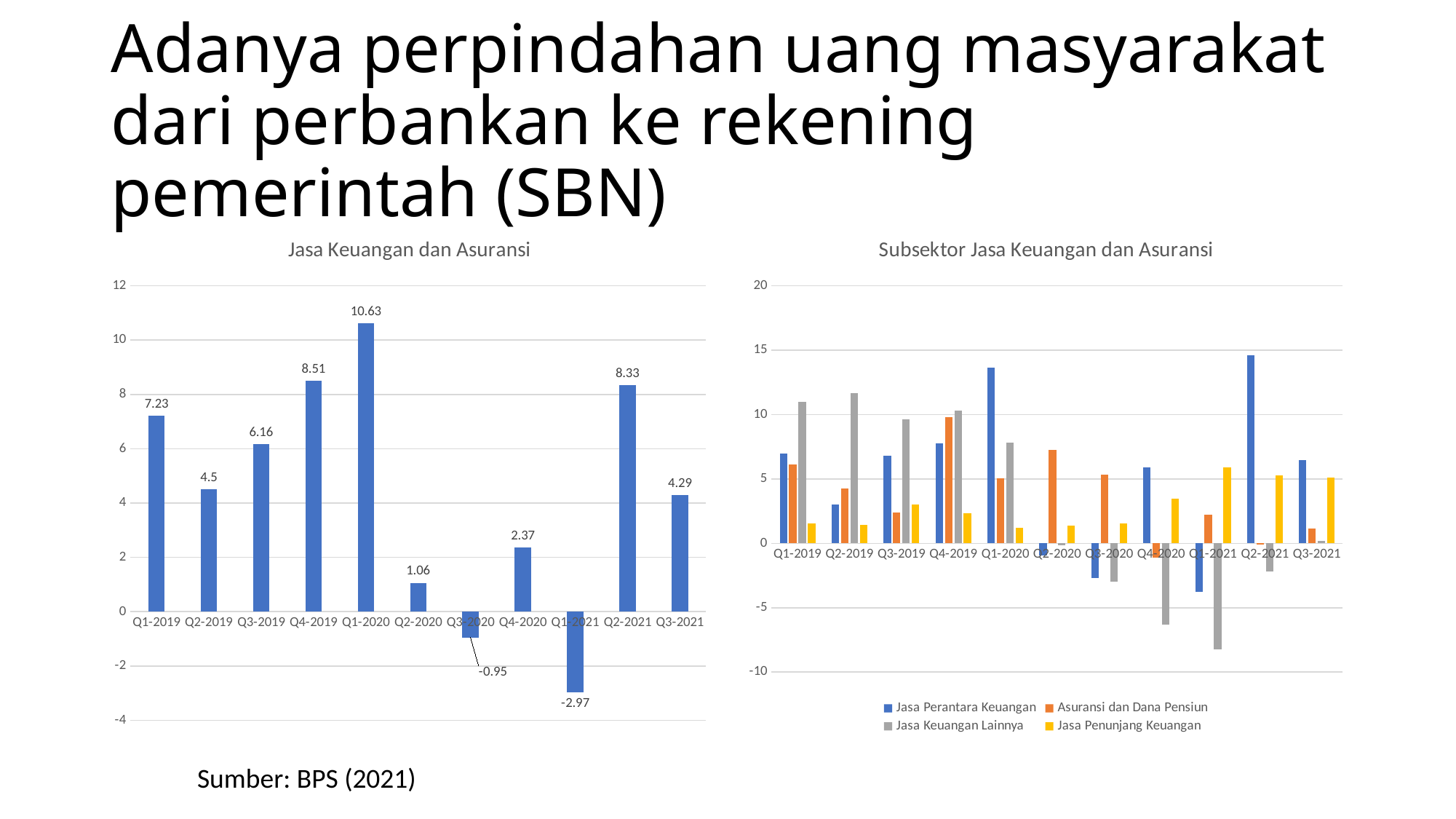
What kind of chart is the one titled "Subsektor Jasa Keuangan dan Asuransi"? bar chart In the chart titled "Jasa Keuangan dan Asuransi", what is the value for Q1-2021? -2.97 How many series does the legend of the chart titled "Subsektor Jasa Keuangan dan Asuransi" list? 4 In the chart titled "Jasa Keuangan dan Asuransi", what is the value for Q1-2020? 10.63 In the chart titled "Jasa Keuangan dan Asuransi", do the values rise or fall from Q1-2020 to Q1-2021? fall In the chart titled "Jasa Keuangan dan Asuransi", what is the difference between the values for Q4-2019 and Q2-2019? 4.01 In the chart titled "Jasa Keuangan dan Asuransi", which quarter has the lowest value? Q1-2021 In the chart titled "Jasa Keuangan dan Asuransi", which quarter has the highest value? Q1-2020 In the chart titled "Subsektor Jasa Keuangan dan Asuransi", is the value for Jasa Perantara Keuangan in Q1-2020 greater or less than 10? greater In the chart titled "Jasa Keuangan dan Asuransi", how many quarters are plotted? 11 In the chart titled "Subsektor Jasa Keuangan dan Asuransi", is the value for Jasa Keuangan Lainnya in Q1-2021 greater or less than -5? less In the chart titled "Jasa Keuangan dan Asuransi", which is larger, the value for Q2-2021 or the value for Q3-2021? Q2-2021